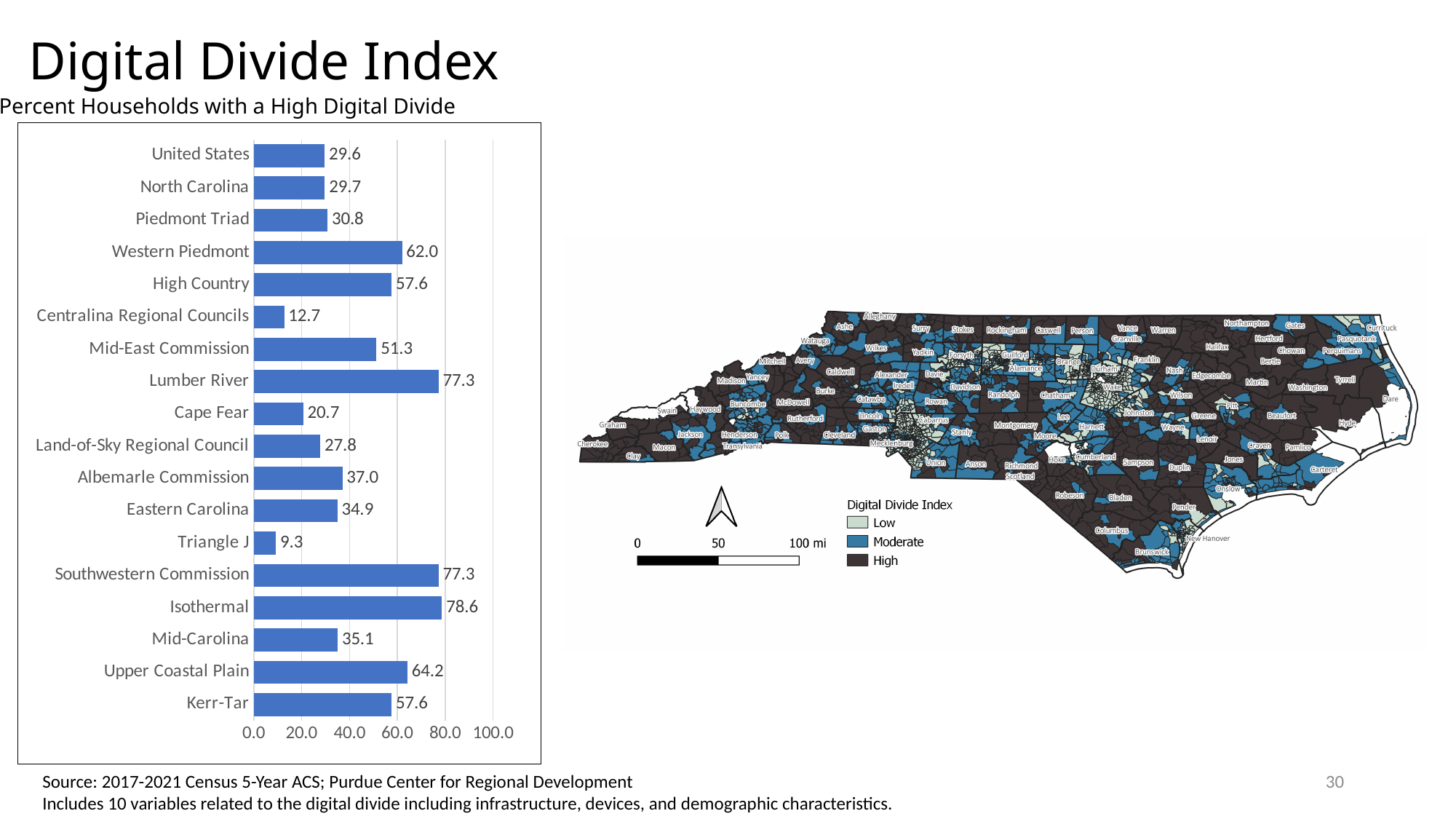
What is the value for Upper Coastal Plain? 64.2 What kind of chart is shown on the left of the slide? Bar chart Is the value for Mid-East Commission greater or less than 40.0? greater What is the value for North Carolina? 29.7 What is the value for Centralina Regional Councils? 12.7 Which is larger, the value for Albemarle Commission or the value for Eastern Carolina? Albemarle Commission Which category has the lowest value in the bar chart? Triangle J What is the value for Lumber River in the bar chart? 77.3 How many categories are shown in the bar chart? 18 What is the difference between the values for Western Piedmont and High Country? 4.4 What is the subtitle printed above the bar chart? Percent Households with a High Digital Divide Which category has the highest value in the bar chart? Isothermal